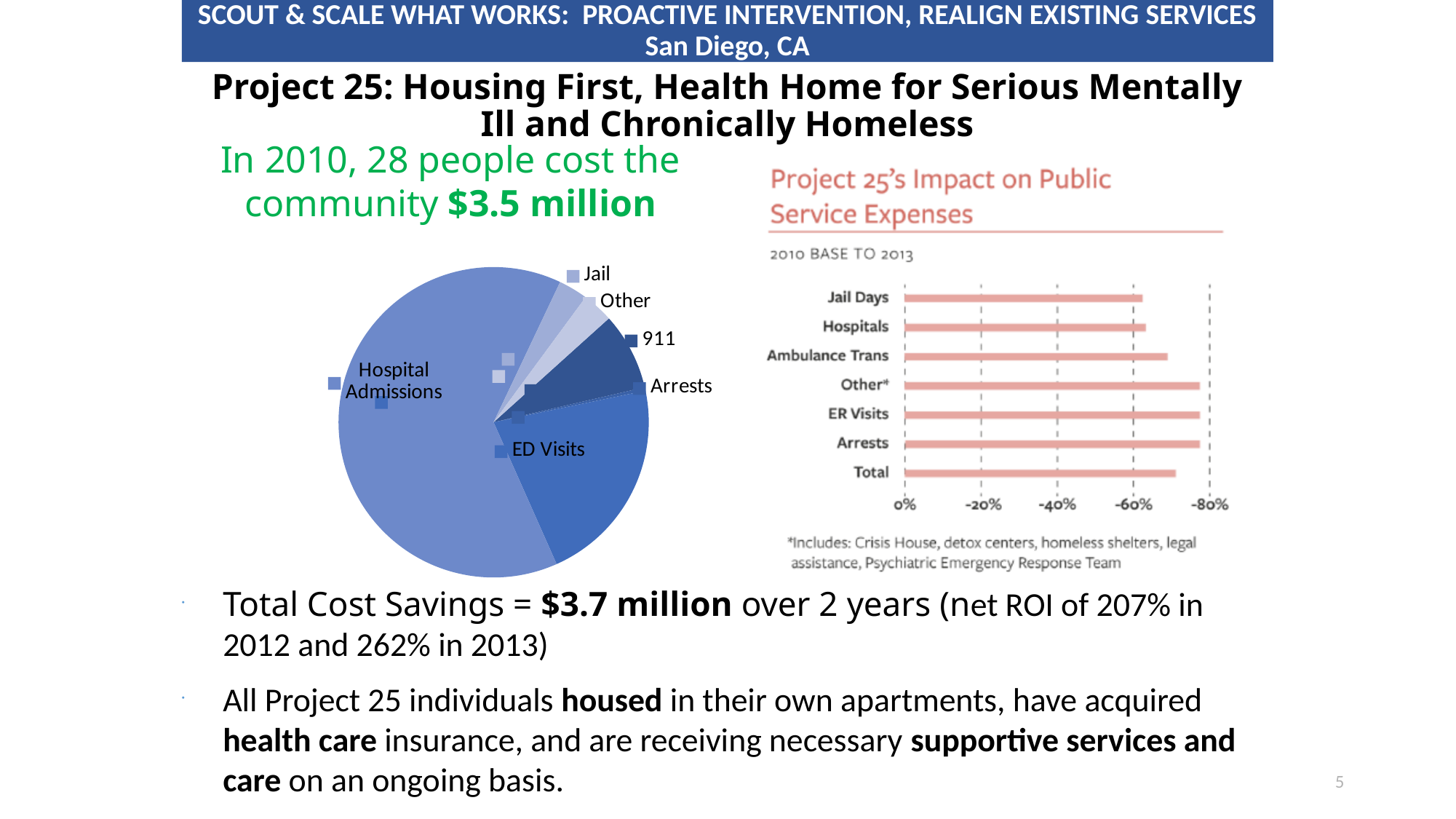
In the pie chart on the left, which slice is larger, ED Visits or Arrests? ED Visits What kind of chart is the chart on the left of the slide? pie chart What kind of chart is the chart titled "Project 25's Impact on Public Service Expenses"? bar chart In the pie chart on the left, which slice is larger, Hospital Admissions or ED Visits? Hospital Admissions How many categories are shown in the chart titled "Project 25's Impact on Public Service Expenses"? 7 In the chart titled "Project 25's Impact on Public Service Expenses", is the percentage reduction for Total greater or less than 60%? greater What period does the subtitle of the chart titled "Project 25's Impact on Public Service Expenses" state the data covers? 2010 base to 2013 In the chart titled "Project 25's Impact on Public Service Expenses", which category shows a larger reduction, Total or Jail Days? Total In the chart titled "Project 25's Impact on Public Service Expenses", is the percentage reduction for Other* greater or less than 60%? greater How many categories are shown in the pie chart on the left? 6 In the pie chart on the left, which category has the largest slice? Hospital Admissions